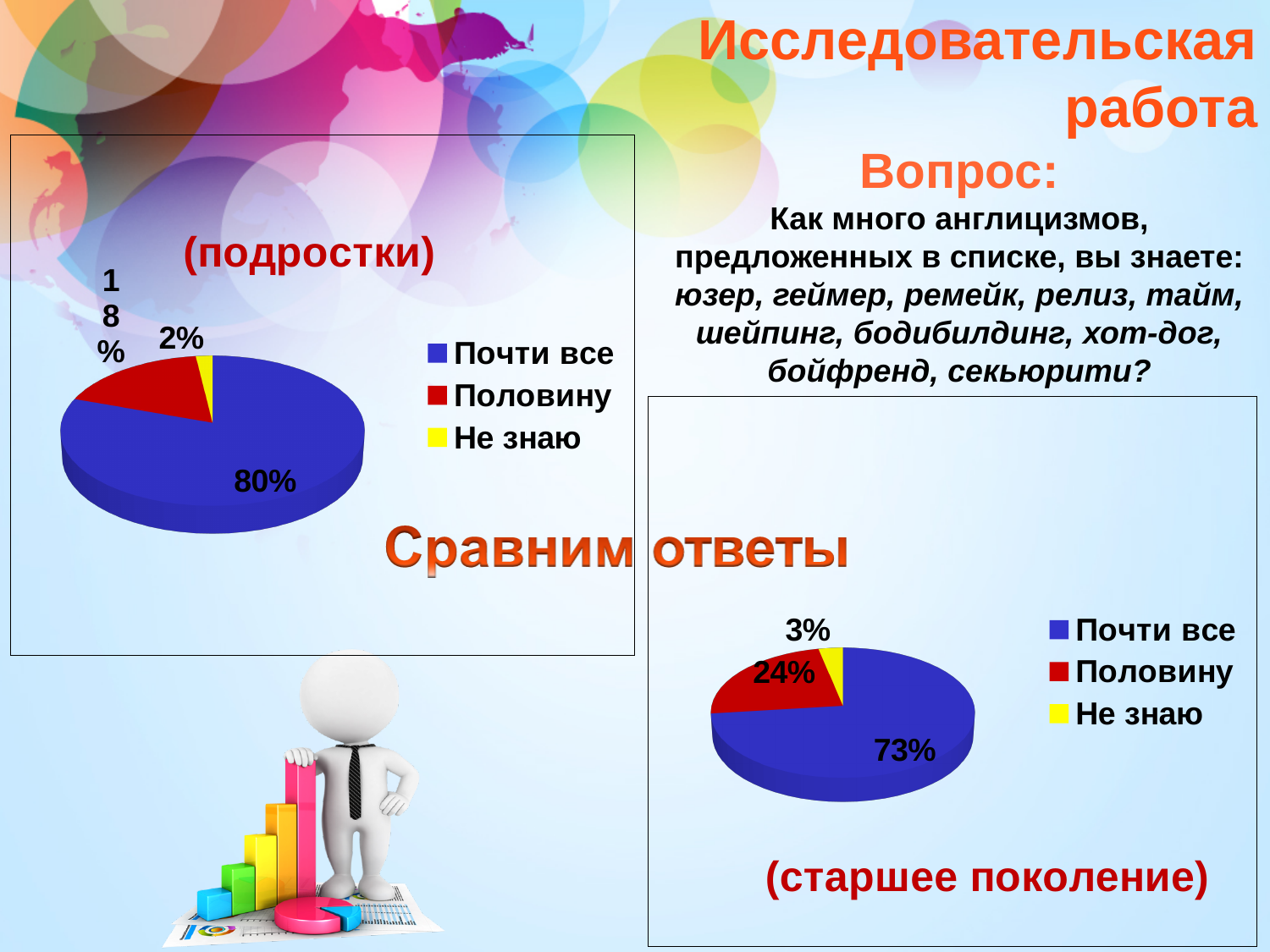
Which chart has the larger share for Половину, (подростки) or (старшее поколение)? (старшее поколение) In the chart titled (подростки), which answer has the largest share? Почти все In the chart titled (подростки), what percentage of respondents answered Почти все? 80% In the chart titled (старшее поколение), what percentage of respondents answered Почти все? 73% In the chart titled (старшее поколение), which answer has the smallest share? Не знаю In the chart titled (подростки), what percentage of respondents answered Половину? 18% What type of chart is the one titled (старшее поколение)? Pie chart What is the difference between the Почти все share in the (подростки) chart and the Почти все share in the (старшее поколение) chart? 7% How many entries does the legend of the (подростки) chart list? 3 In the chart titled (старшее поколение), what percentage of respondents answered Половину? 24% In the chart titled (старшее поколение), what percentage of respondents answered Не знаю? 3% In the chart titled (подростки), what percentage of respondents answered Не знаю? 2%